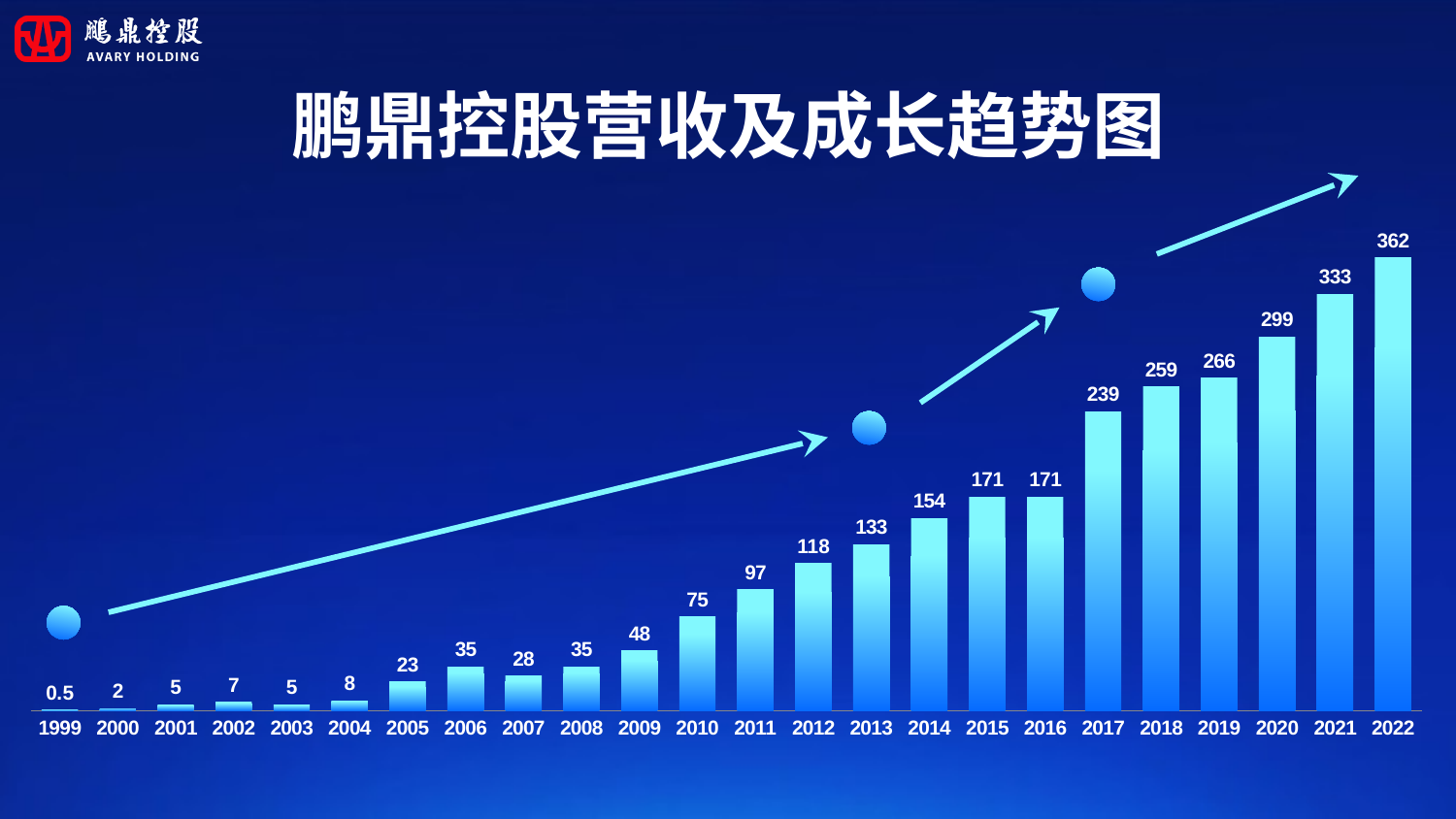
How many years are shown on the x axis? 24 What kind of chart is this? Bar chart Which year has the highest value? 2022 What is the difference between the values for 2017 and 2016? 68 Which is larger, the value for 2007 or the value for 2008? 2008 What is the value for 1999? 0.5 What is the difference between the values for 2022 and 2021? 29 What is the title of the chart? 鹏鼎控股营收及成长趋势图 Which year has the lowest value? 1999 What is the value for 2010? 75 What is the value for 2022? 362 Do the values generally rise or fall from 1999 to 2022? Rise